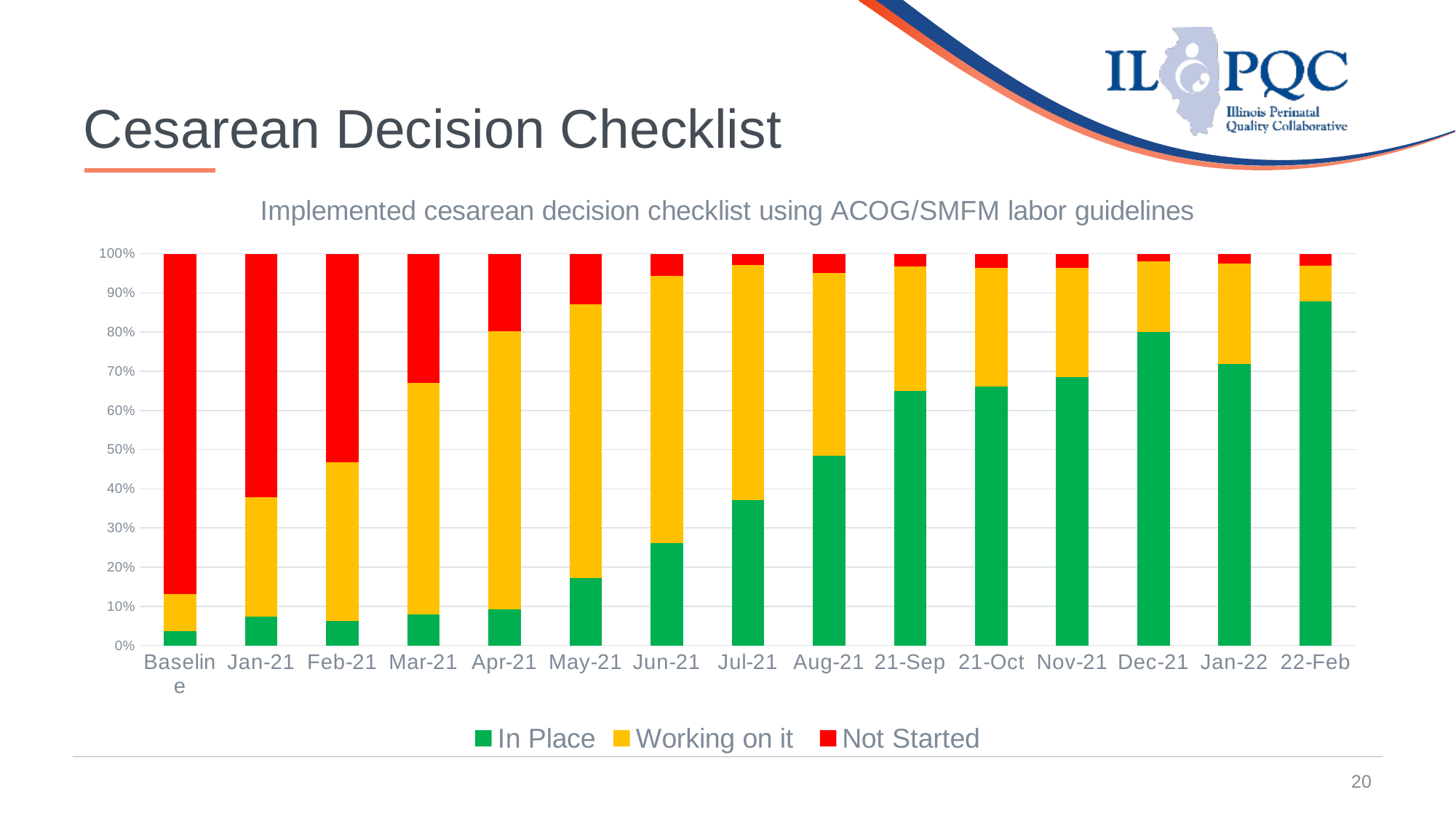
Which category has the smallest 'In Place' share? Baseline Does the 'In Place' share rise or fall from Baseline to 22-Feb? Rise Which is larger, the 'In Place' share for Jul-21 or for Aug-21? Aug-21 What kind of chart is shown on the slide? Stacked bar chart Is the 'In Place' value for Dec-21 greater or less than 70%? greater How many series does the legend list? 3 Is the 'In Place' value for Jun-21 greater or less than 30%? less Which category has the largest 'In Place' share? 22-Feb How many categories are shown along the x axis? 15 What is the total of the stacked bar for Mar-21? 100% Which category has the largest 'Not Started' share? Baseline What is the title of the chart? Implemented cesarean decision checklist using ACOG/SMFM labor guidelines